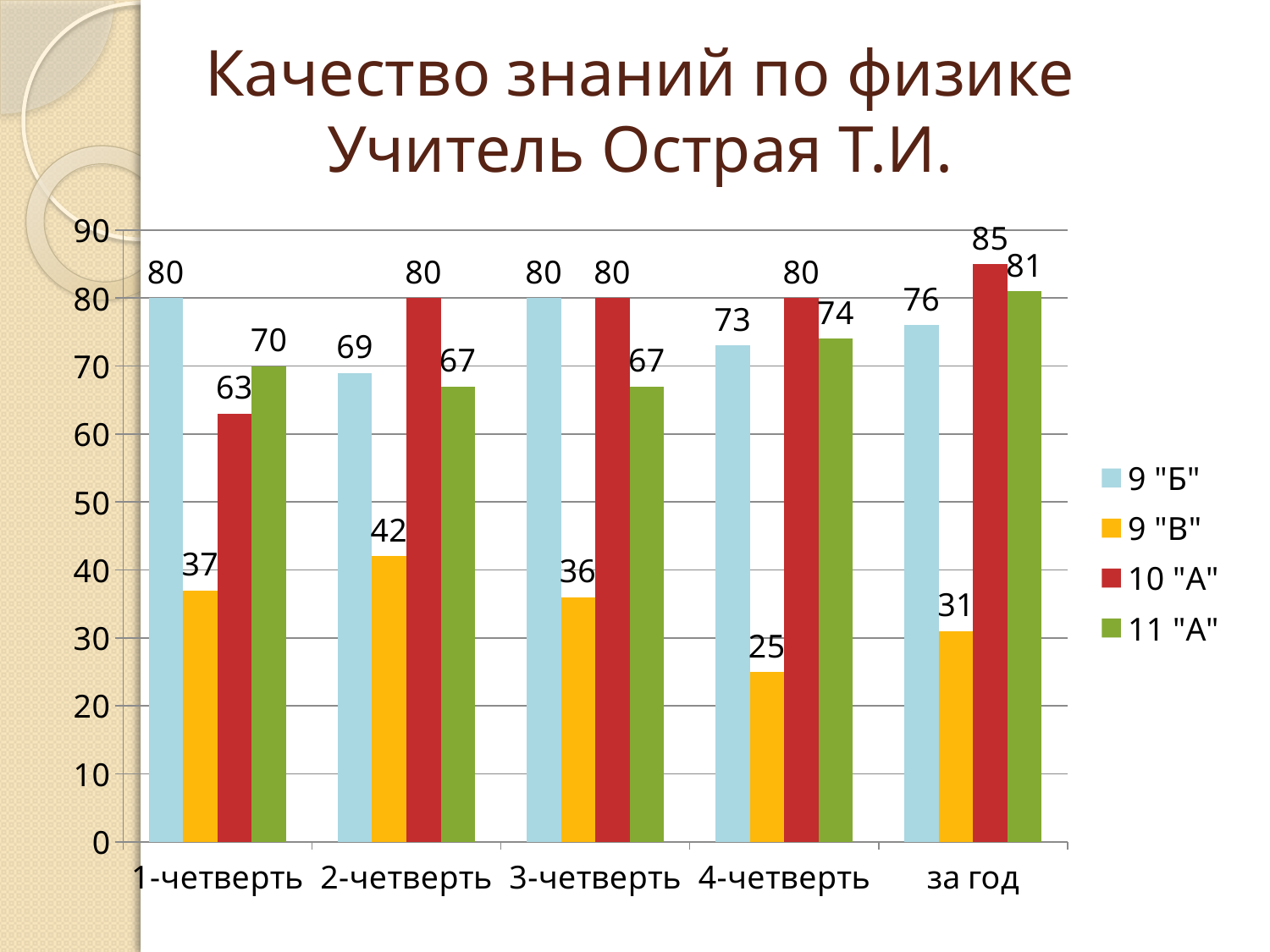
What is the value for 9 "Б" in 1-четверть? 80 Which is larger in 4-четверть: the value for 9 "Б" or the value for 11 "А"? 11 "А" How many categories are shown on the x axis? 5 Which series has the lowest value in 3-четверть? 9 "В" How many series does the legend list? 4 What is the difference between the 10 "А" and 9 "В" values in 1-четверть? 26 Which series has the highest value for за год? 10 "А" Do the values for 10 "А" rise or fall from 1-четверть to за год? rise What is the value for 11 "А" in 2-четверть? 67 What kind of chart is shown on the slide? bar chart What is the value for 9 "В" in 4-четверть? 25 What is the value for 10 "А" for за год? 85